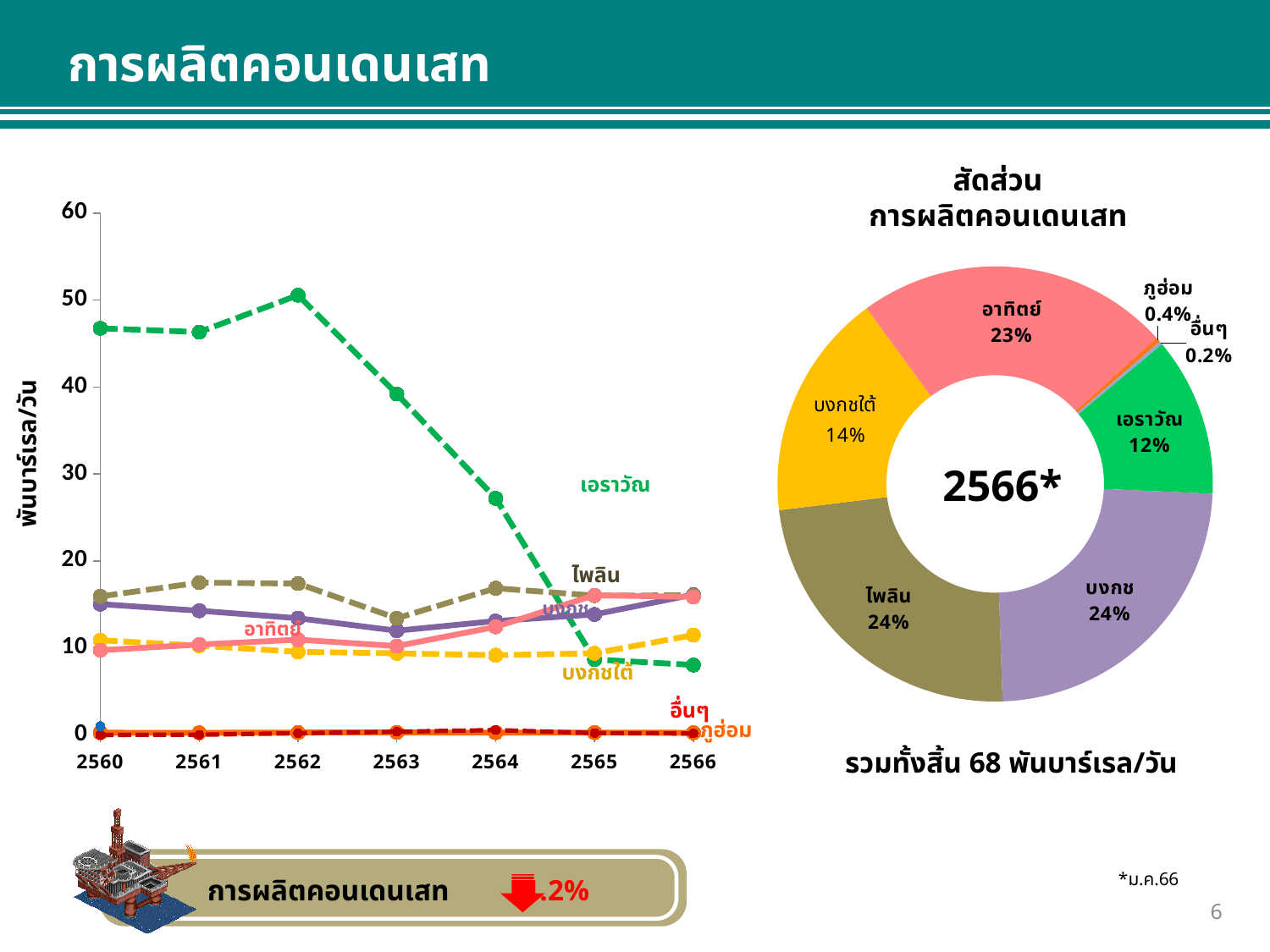
In the donut chart titled สัดส่วนการผลิตคอนเดนเสท, which slice has the smallest share? อื่นๆ In the donut chart titled สัดส่วนการผลิตคอนเดนเสท, what share does เอราวัณ have? 12% In the donut chart titled สัดส่วนการผลิตคอนเดนเสท, how many percentage points larger is the share of บงกช than the share of เอราวัณ? 12 In the donut chart titled สัดส่วนการผลิตคอนเดนเสท, what share does บงกชใต้ have? 14% In the line chart on the left, which series has the highest value in 2560? เอราวัณ In the line chart on the left, how many years are shown on the x axis? 7 In the line chart on the left, is the value for เอราวัณ in 2562 greater or less than 40? greater In the line chart on the left, does the value for เอราวัณ rise or fall from 2562 to 2566? fall What kind of chart is the chart on the right of the slide? Pie (donut) chart In the donut chart titled สัดส่วนการผลิตคอนเดนเสท, what share does อาทิตย์ have? 23% In the donut chart titled สัดส่วนการผลิตคอนเดนเสท, how many slices are there? 7 What kind of chart is the chart on the left of the slide? Line chart